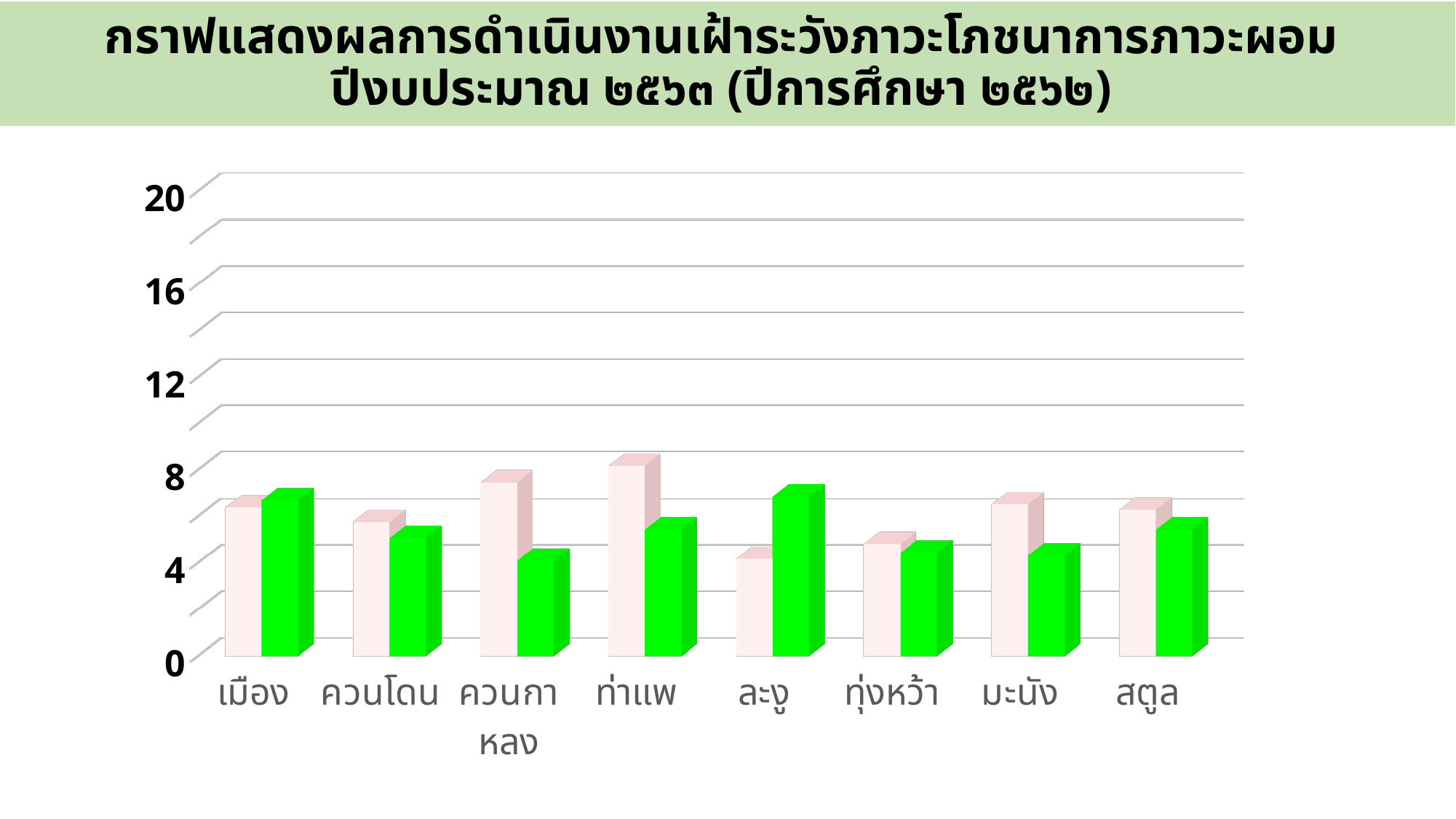
Is the value of the green bar for ละงู greater or less than 4? greater Is the value of the green bar for ควนกาหลง greater or less than 8? less For ควนกาหลง, which bar is taller, the pink bar or the green bar? pink bar What is the highest value shown on the y axis of the chart? 20 What kind of chart is shown on the slide? bar chart Is the value of the pink bar for ท่าแพ greater or less than 4? greater Which category has the tallest pink bar? ท่าแพ For ท่าแพ, which bar is taller, the pink bar or the green bar? pink bar Which category has the shortest pink bar? ละงู For ละงู, which bar is taller, the pink bar or the green bar? green bar How many bars are shown for each category on the chart? 2 How many categories are shown on the x axis of the chart? 8